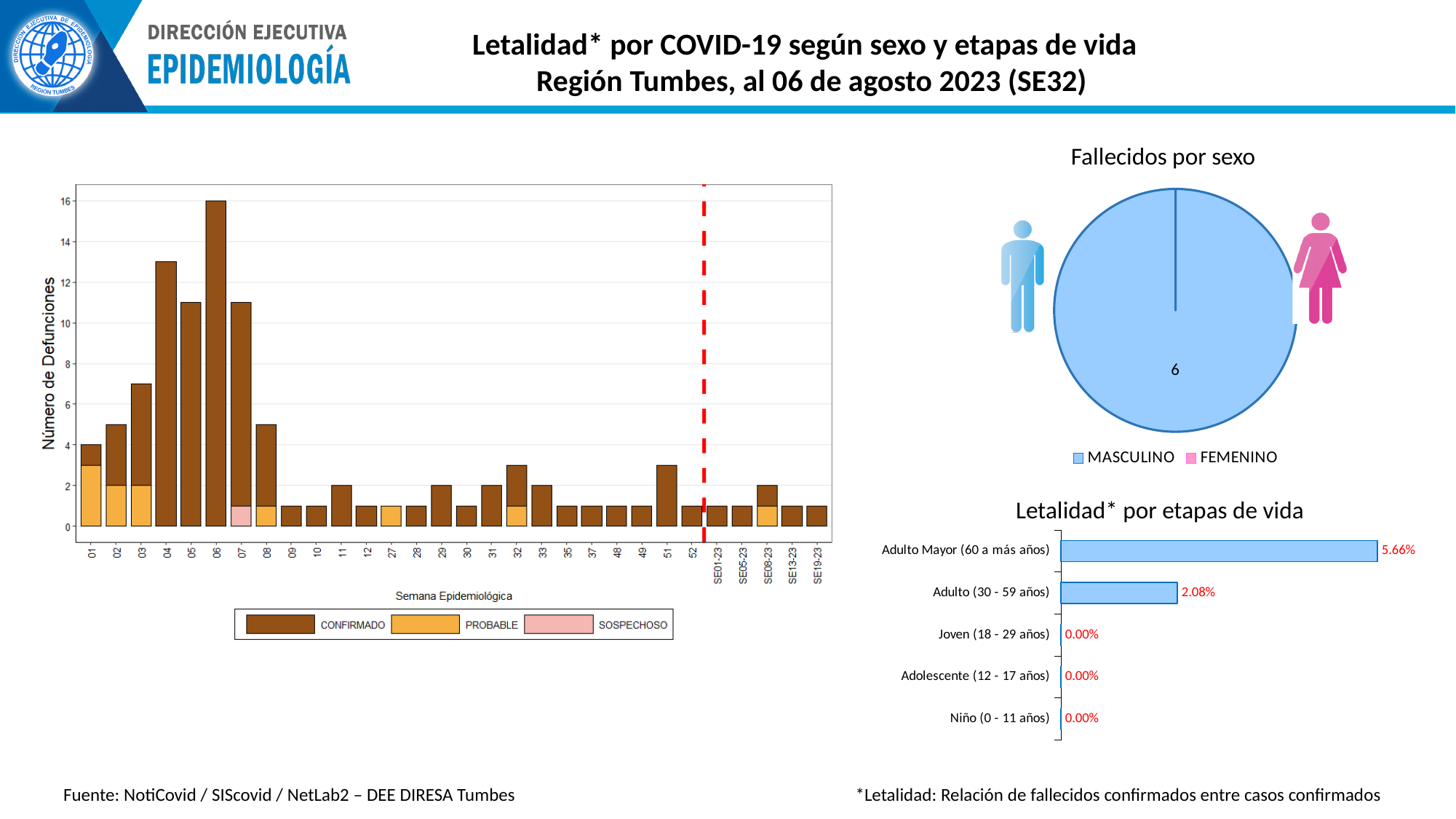
In the 'Letalidad* por etapas de vida' chart, what is the value for Adulto (30 - 59 años)? 2.08% In the 'Letalidad* por etapas de vida' chart, how many age groups are shown? 5 In the 'Fallecidos por sexo' pie chart, what value is shown for MASCULINO? 6 In the 'Número de Defunciones' chart on the left, is the value for week 04 greater or less than 12? greater In the 'Letalidad* por etapas de vida' chart, which age group has the highest value? Adulto Mayor (60 a más años) In the 'Número de Defunciones' chart on the left, which epidemiological week has the highest bar? 06 How many entries does the legend of the 'Fallecidos por sexo' chart list? 2 In the 'Letalidad* por etapas de vida' chart, what is the value for Adulto Mayor (60 a más años)? 5.66% In the 'Letalidad* por etapas de vida' chart, what is the difference between the values for Adulto Mayor (60 a más años) and Adulto (30 - 59 años)? 3.58% How many series does the legend of the 'Número de Defunciones' chart on the left list? 3 In the 'Número de Defunciones' chart on the left, what is the total height of the bar for week 06? 16 What kind of chart is 'Fallecidos por sexo'? pie chart